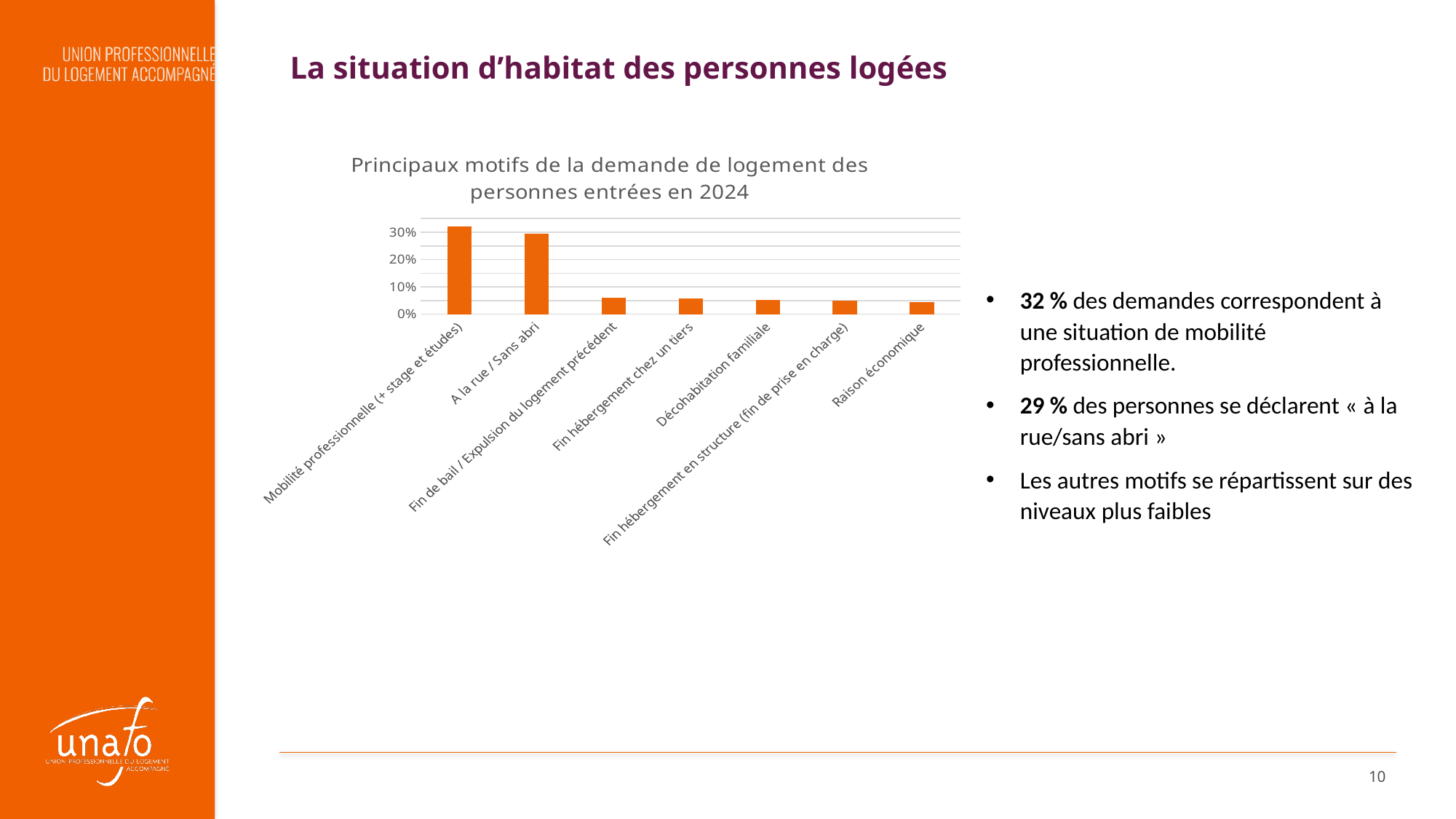
What colour are the bars in the chart? orange Which is larger: the value for 'Mobilité professionnelle (+ stage et études)' or for 'A la rue / Sans abri'? Mobilité professionnelle (+ stage et études) Which is larger: the value for 'Fin de bail / Expulsion du logement précédent' or for 'Raison économique'? Fin de bail / Expulsion du logement précédent Which category has the highest value in the chart? Mobilité professionnelle (+ stage et études) Is the value for 'Raison économique' greater or less than 10%? less Is the value for 'Fin de bail / Expulsion du logement précédent' greater or less than 10%? less Is the value for 'A la rue / Sans abri' greater or less than 20%? greater What is the title of the chart? Principaux motifs de la demande de logement des personnes entrées en 2024 What kind of chart is shown on the slide? bar chart Do the values rise or fall from left to right along the x axis? fall How many categories are shown on the x axis of the chart? 7